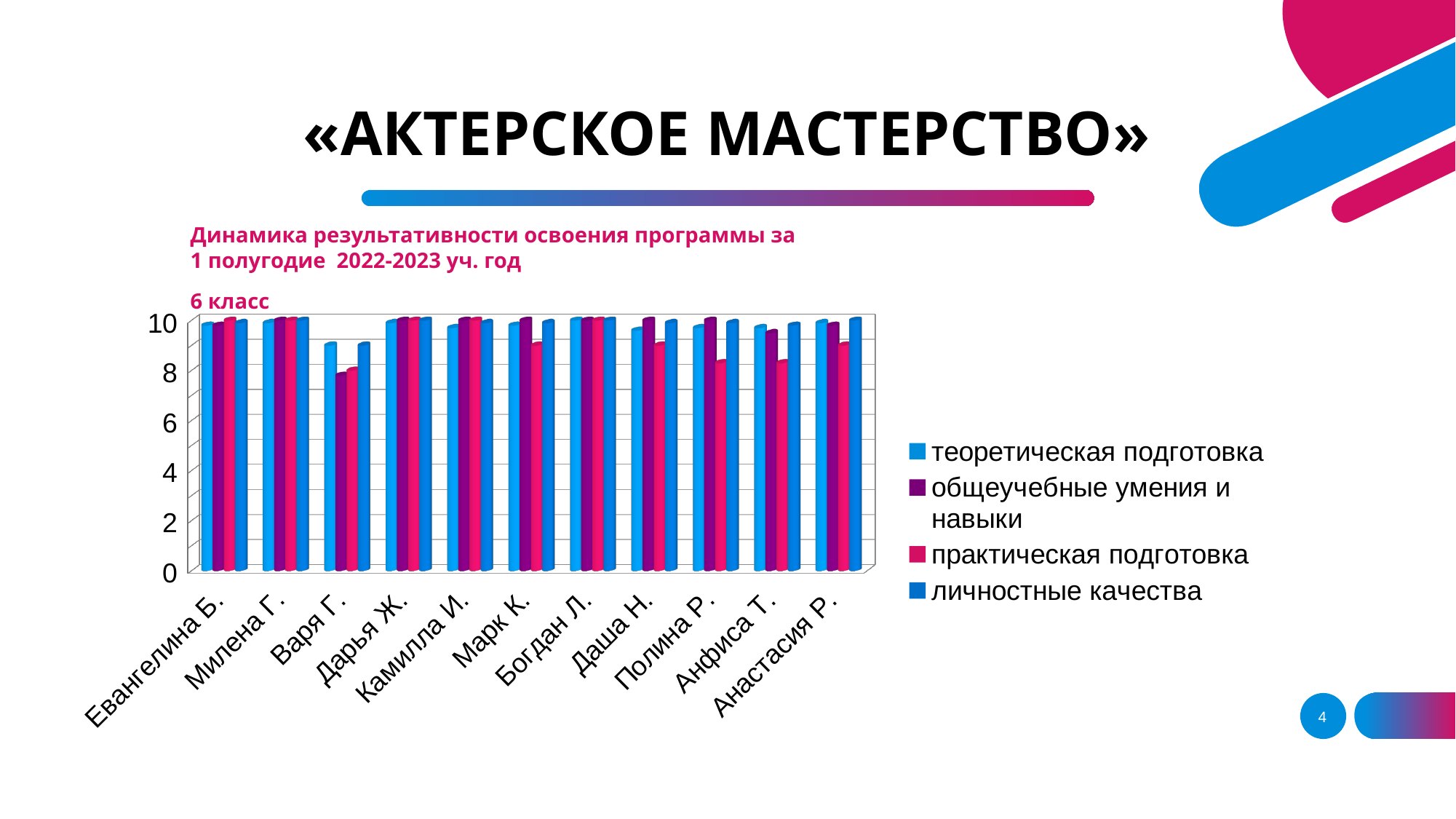
Which student has the lowest value for теоретическая подготовка? Варя Г. How many series does the chart legend list? 4 Is the value of практическая подготовка for Полина Р. greater or less than 9? less How many students (categories) are shown on the x axis of the chart? 11 What kind of chart is shown on the slide? bar chart Is the value of практическая подготовка for Анфиса Т. greater or less than 9? less Is the value of теоретическая подготовка for Евангелина Б. greater or less than 8? greater For Полина Р., which is larger: общеучебные умения и навыки or практическая подготовка? общеучебные умения и навыки For Варя Г., which is larger: теоретическая подготовка or общеучебные умения и навыки? теоретическая подготовка Which student has the lowest value for общеучебные умения и навыки? Варя Г. Which class is the chart about, according to the label above it? 6 класс